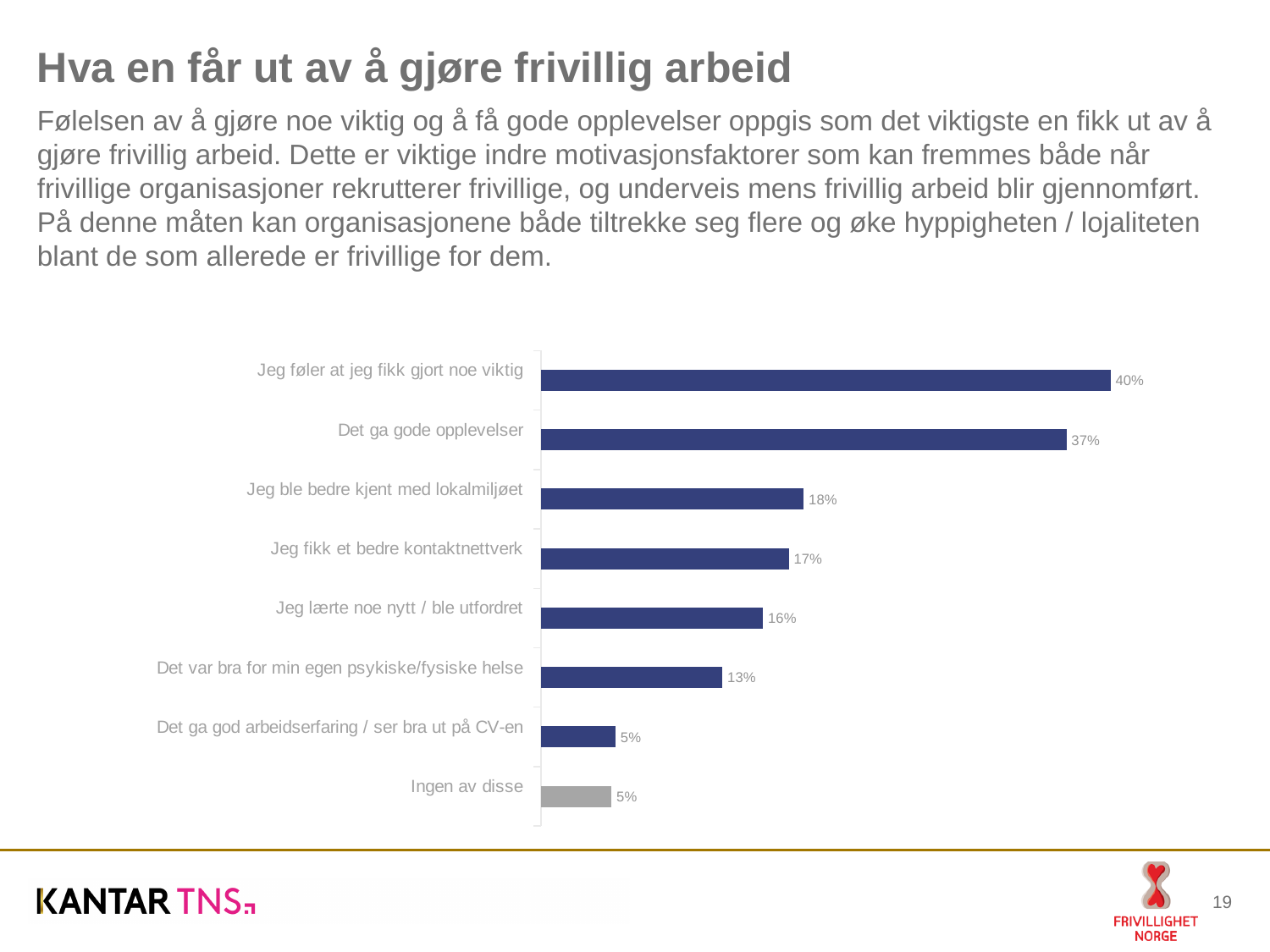
What is the difference between "Jeg ble bedre kjent med lokalmiljøet" and "Det var bra for min egen psykiske/fysiske helse"? 5% What kind of chart is shown on the slide? Bar chart What is the value for "Det var bra for min egen psykiske/fysiske helse"? 13% Which is larger: "Jeg fikk et bedre kontaktnettverk" or "Jeg lærte noe nytt / ble utfordret"? Jeg fikk et bedre kontaktnettverk What is the value for "Det ga god arbeidserfaring / ser bra ut på CV-en"? 5% What is the value for "Jeg føler at jeg fikk gjort noe viktig"? 40% What is the difference between "Jeg føler at jeg fikk gjort noe viktig" and "Det ga gode opplevelser"? 3% Which category's bar is shown in grey rather than blue? Ingen av disse How many categories are shown in the chart? 8 Which category has the highest value? Jeg føler at jeg fikk gjort noe viktig What is the value for "Det ga gode opplevelser"? 37% What is the value for "Jeg ble bedre kjent med lokalmiljøet"? 18%